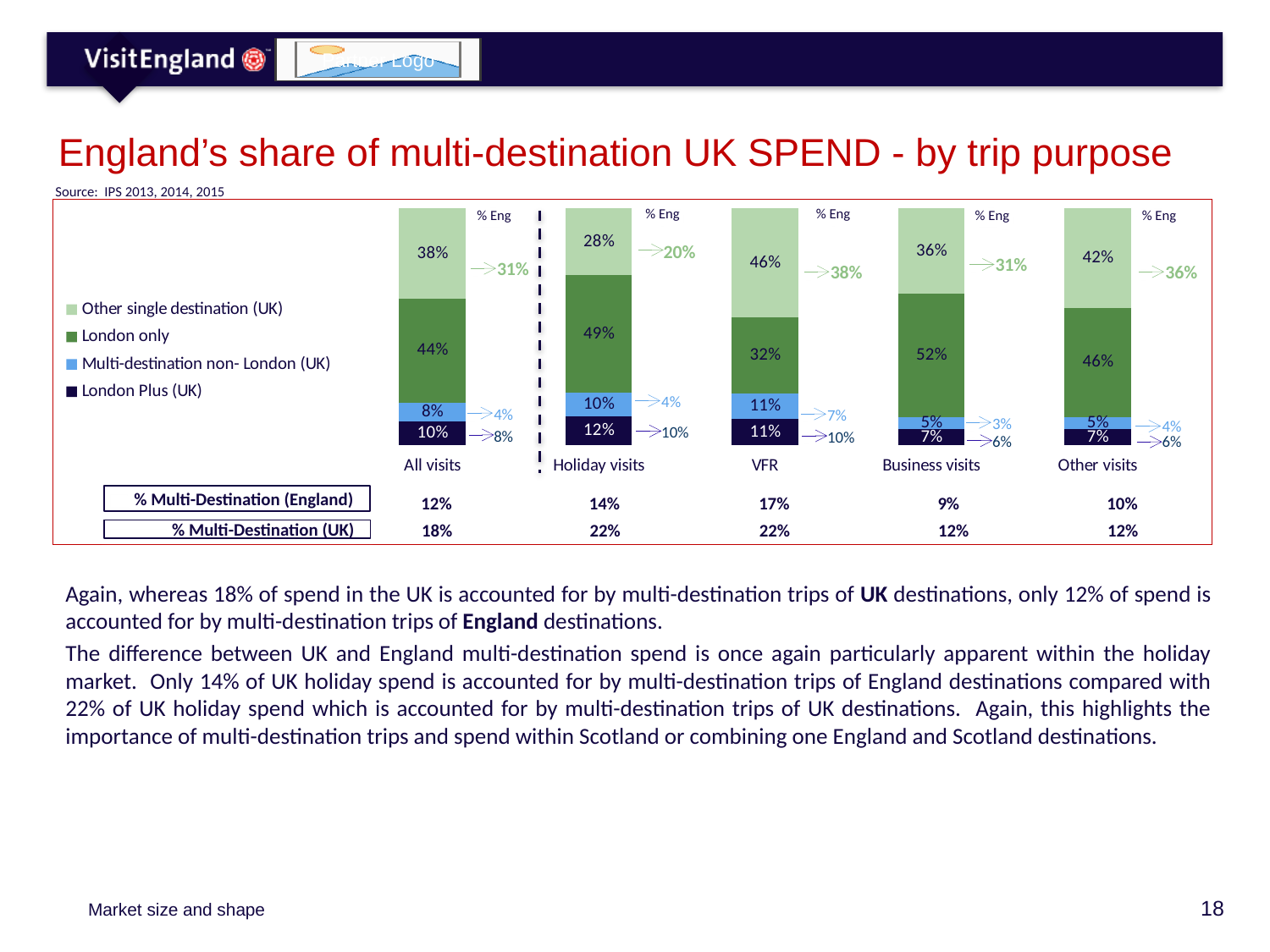
What is the value for London only in the Holiday visits bar? 49% How many trip purpose categories are shown along the x axis of the chart? 5 Which category has the highest value for London only? Business visits What kind of chart is shown on the slide? stacked bar chart Which category has the lowest value for Other single destination (UK)? Holiday visits How many series does the chart legend list? 4 What is the title of the chart on the slide? England's share of multi-destination UK SPEND - by trip purpose What is the value for London Plus (UK) in the Business visits bar? 7% Which is larger: the Other single destination (UK) value for Other visits or for All visits? Other visits What is the value for Other single destination (UK) in the VFR bar? 46% What is the value for Multi-destination non- London (UK) in the All visits bar? 8% What is the difference between the London only values for Business visits and VFR? 20%